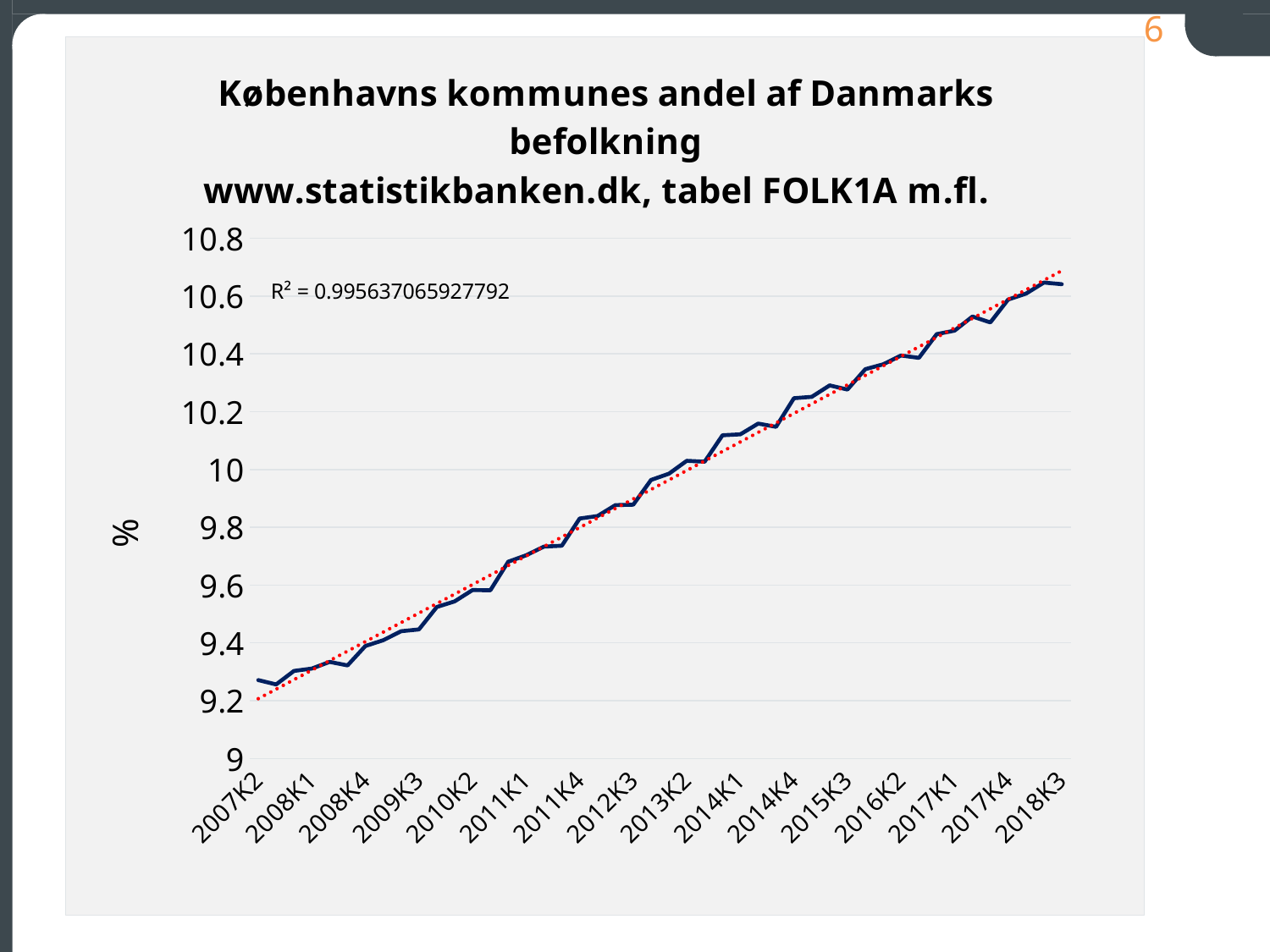
Which is larger, the value for 2007K2 or the value for 2018K3? 2018K3 What R² value is printed on the chart? 0.995637065927792 Is the value for 2018K3 greater or less than 10.4? greater Is the value for 2017K1 greater or less than 10.4? greater Is the value for 2015K3 greater or less than 10.2? greater How many category labels are shown on the x axis? 16 Do the values rise or fall from 2007K2 to 2018K3? rise What is the label on the y axis? % Which is larger, the value for 2014K1 or the value for 2010K2? 2014K1 What kind of chart is shown on the slide? line chart